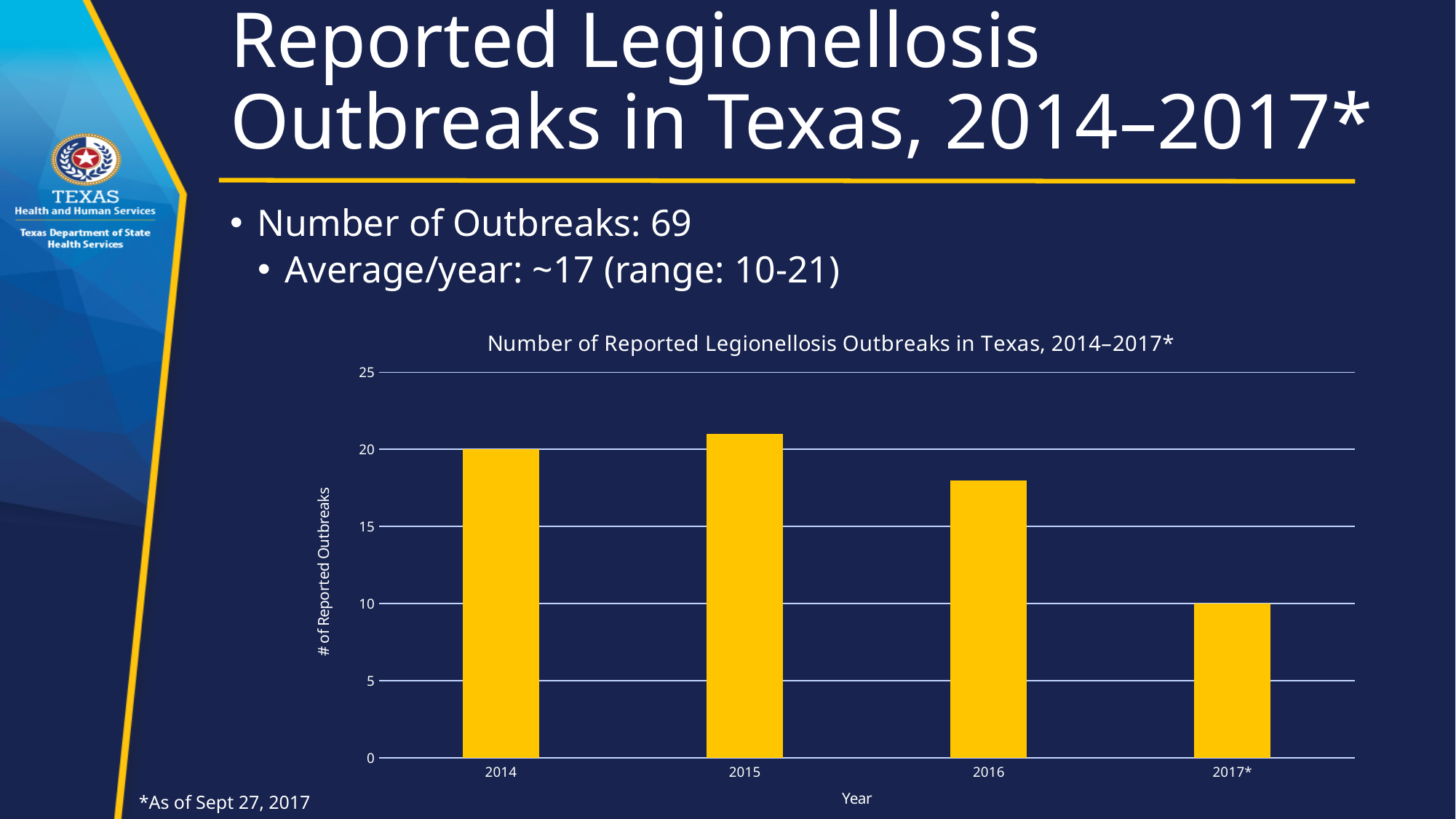
What is the number of reported outbreaks for 2017*? 10 What is the number of reported outbreaks for 2014? 20 Which year has the highest number of reported outbreaks? 2015 Is the value for 2016 greater or less than 20? less Do the values rise or fall from 2015 to 2017*? fall What is the label of the y axis of the chart? # of Reported Outbreaks How many years are plotted on the x axis of the chart? 4 What is the difference between the number of reported outbreaks in 2014 and in 2017*? 10 Is the value for 2015 greater or less than 20? greater What type of chart is shown on the slide? bar chart Which year has the lowest number of reported outbreaks? 2017* Is the value for 2016 greater or less than 15? greater